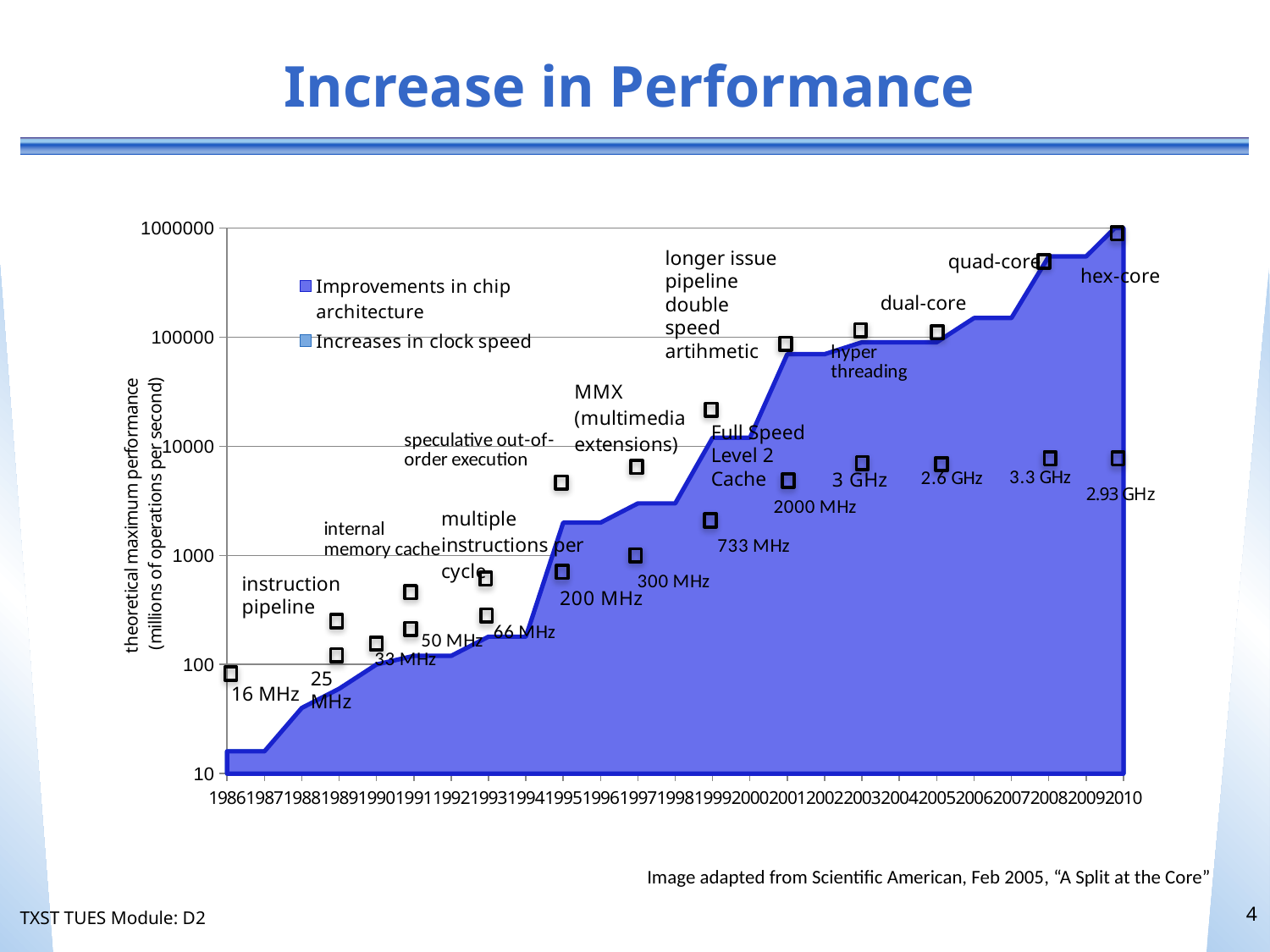
Which year has the larger plotted value, 1999 or 2008? 2008 Is the value for 1986 greater or less than 100? less Is the value for 2010 greater or less than 100000? greater What is the label on the y axis of the chart? theoretical maximum performance (millions of operations per second) What are the two legend entries on the chart? Improvements in chip architecture; Increases in clock speed What kind of chart is shown on the slide? area chart Do the plotted values rise or fall from 1986 to 2010? rise Is the value for 1995 greater or less than 1000? greater How many years are shown along the x axis of the chart? 25 How many series does the legend list? 2 Which year has the lowest plotted performance value? 1986 and 1987 (tied) Which year has the highest plotted performance value? 2010